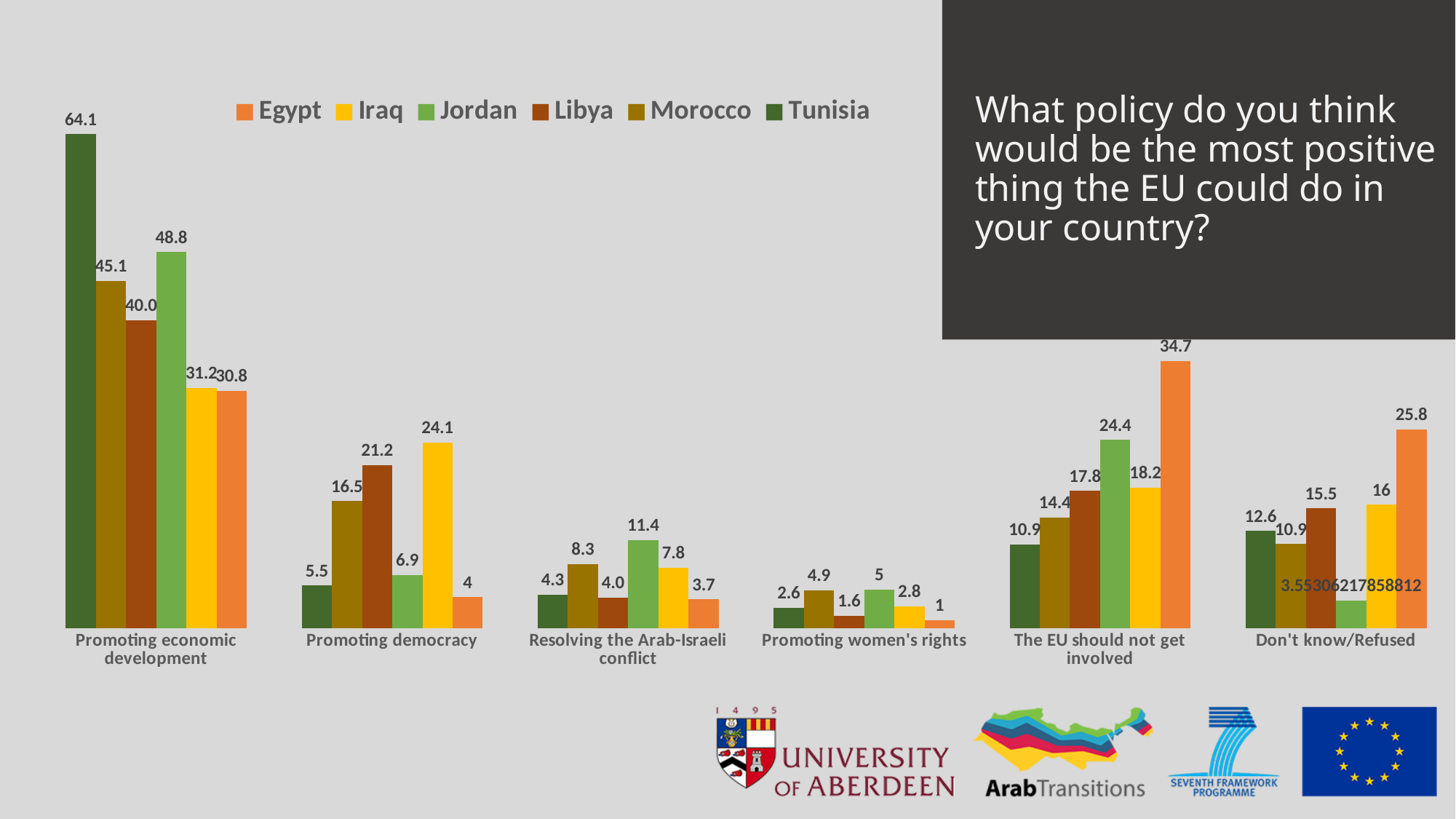
How many policy categories are shown on the x axis? 6 Which country has the lowest value in the 'Promoting women's rights' category? Egypt How many countries does the legend list? 6 What is the value for Iraq in the 'Don't know/Refused' category? 16 In the 'Promoting democracy' category, which is larger: Libya or Morocco? Libya What kind of chart is shown on the slide? Bar chart What question does the slide title ask? What policy do you think would be the most positive thing the EU could do in your country? What is the value for Jordan in the 'Resolving the Arab-Israeli conflict' category? 11.4 Which country has the highest value in the 'Promoting democracy' category? Iraq What is the value for Egypt in the 'The EU should not get involved' category? 34.7 What is the difference between Jordan's and Egypt's values in the 'Promoting economic development' category? 18.0 What is the value for Tunisia in the 'Promoting economic development' category? 64.1